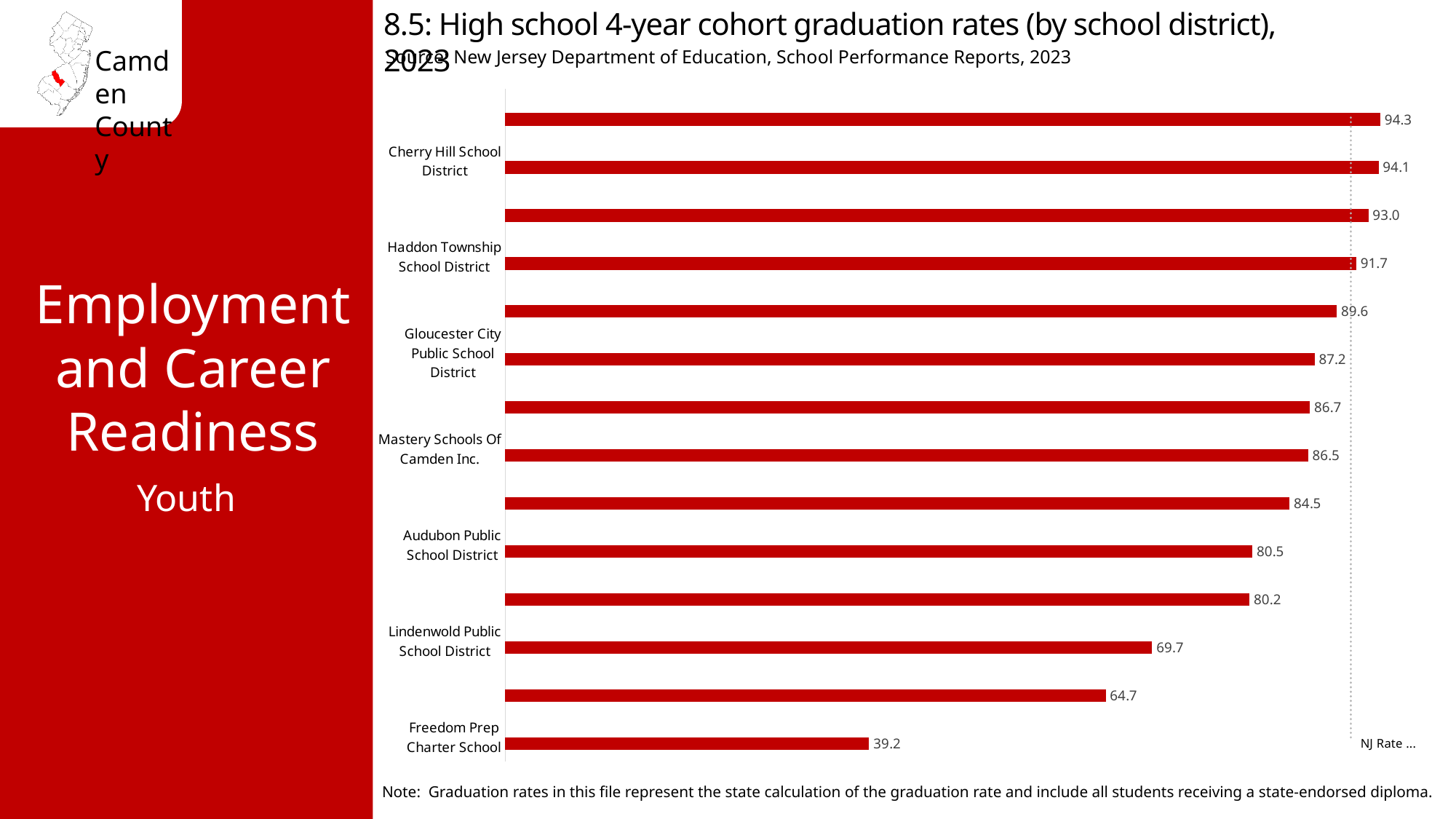
What is the graduation rate for Freedom Prep Charter School? 39.2 What does the dotted vertical line on the chart represent? NJ Rate Which labeled school district has the lowest graduation rate? Freedom Prep Charter School Which has a higher graduation rate, Gloucester City Public School District or Audubon Public School District? Gloucester City Public School District What is the graduation rate for Mastery Schools Of Camden Inc.? 86.5 What is the difference between the graduation rates of Cherry Hill School District and Haddon Township School District? 2.4 What kind of chart is shown on the slide? Bar chart What is the graduation rate for Lindenwold Public School District? 69.7 What is the highest graduation rate value shown on the chart? 94.3 How many bars are plotted on the chart? 14 What is the difference between the graduation rates of Audubon Public School District and Lindenwold Public School District? 10.8 What is the graduation rate for Cherry Hill School District? 94.1